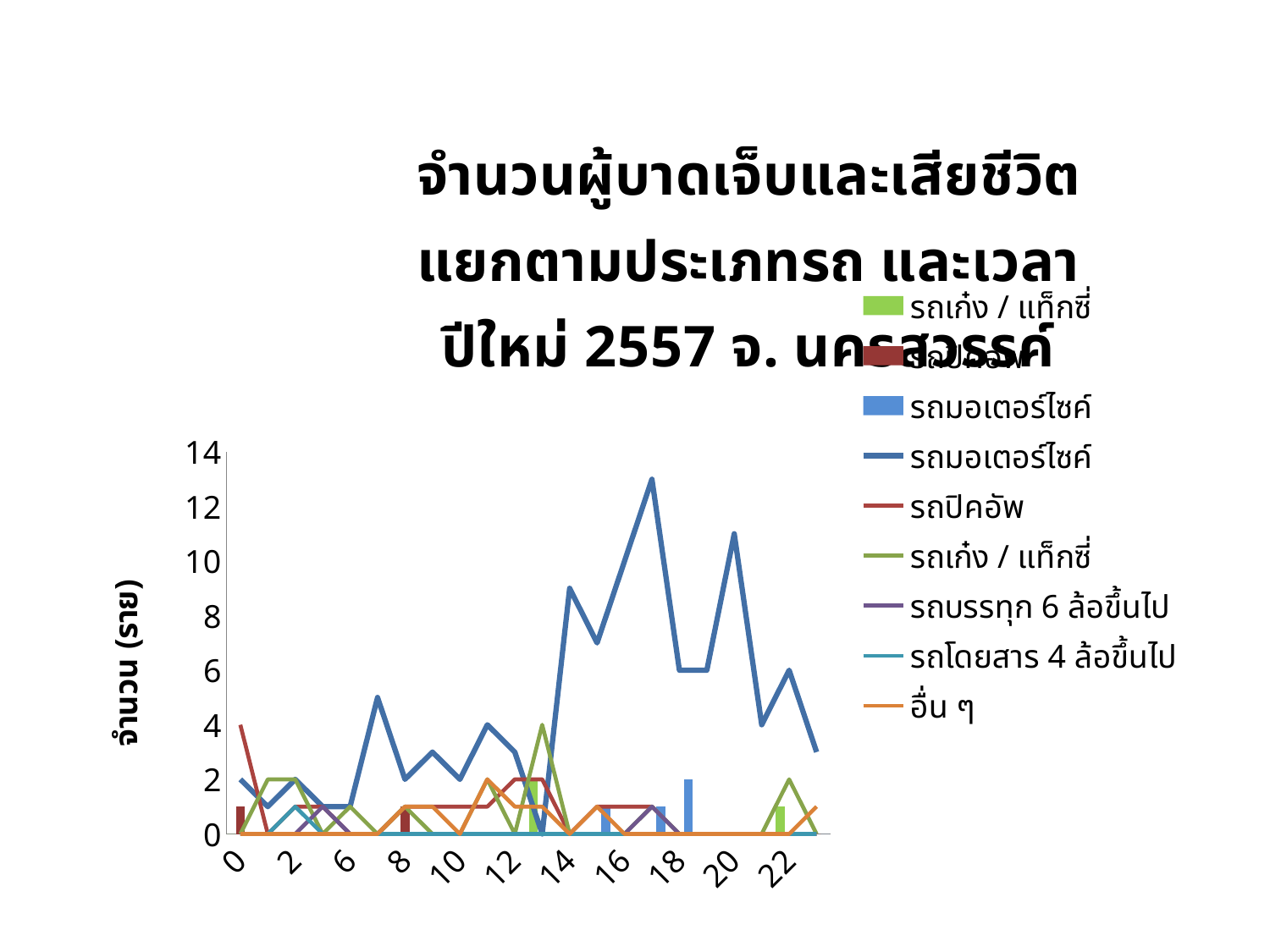
Is the value of the รถมอเตอร์ไซค์ line at hour 17 greater or less than 12? greater What is the value of the รถมอเตอร์ไซค์ line at hour 0? 2 What kind of chart is shown on the slide? A combined line and bar chart What is the highest tick value shown on the vertical axis? 14 How many series does the legend list? 9 Which series reaches the highest value on the chart? รถมอเตอร์ไซค์ Which is larger: the รถมอเตอร์ไซค์ line at hour 17 or at hour 19? hour 17 What is the value of the รถมอเตอร์ไซค์ line at hour 18? 6 What is the label on the vertical axis? จำนวน (ราย) At which hour does the รถมอเตอร์ไซค์ line reach its highest value? 17 Is the value of the รถมอเตอร์ไซค์ line at hour 19 greater or less than 10? less